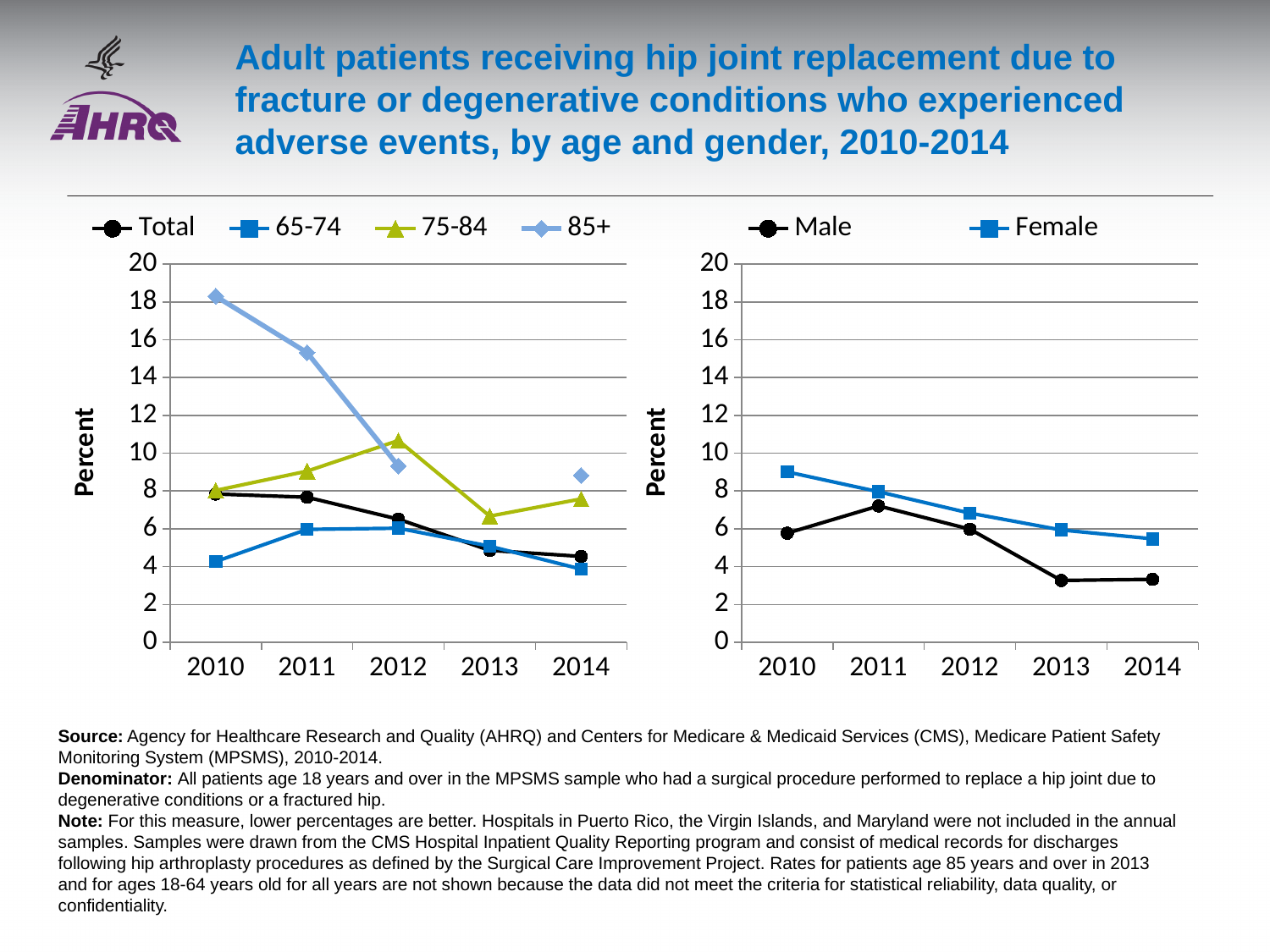
In the right chart (by gender), is the value for Male in 2013 greater or less than 4? less In the left chart (by age), which series has the lowest value in 2010? 65-74 In the right chart (by gender), does the Female series rise or fall from 2010 to 2014? fall In the left chart (by age), is the value for 85+ in 2010 greater or less than 16? greater In the right chart (by gender), is the value for Female in 2010 greater or less than 8? greater How many series does the legend of the right chart (by gender) list? 2 In the left chart (by age), which series has the highest value in 2010? 85+ How many years are shown on the x axis of the right chart (by gender)? 5 In the right chart (by gender), which is larger in 2014, Male or Female? Female What kind of chart is the left chart (by age)? line chart How many series does the legend of the left chart (by age) list? 4 What is the y-axis label on the left chart (by age)? Percent